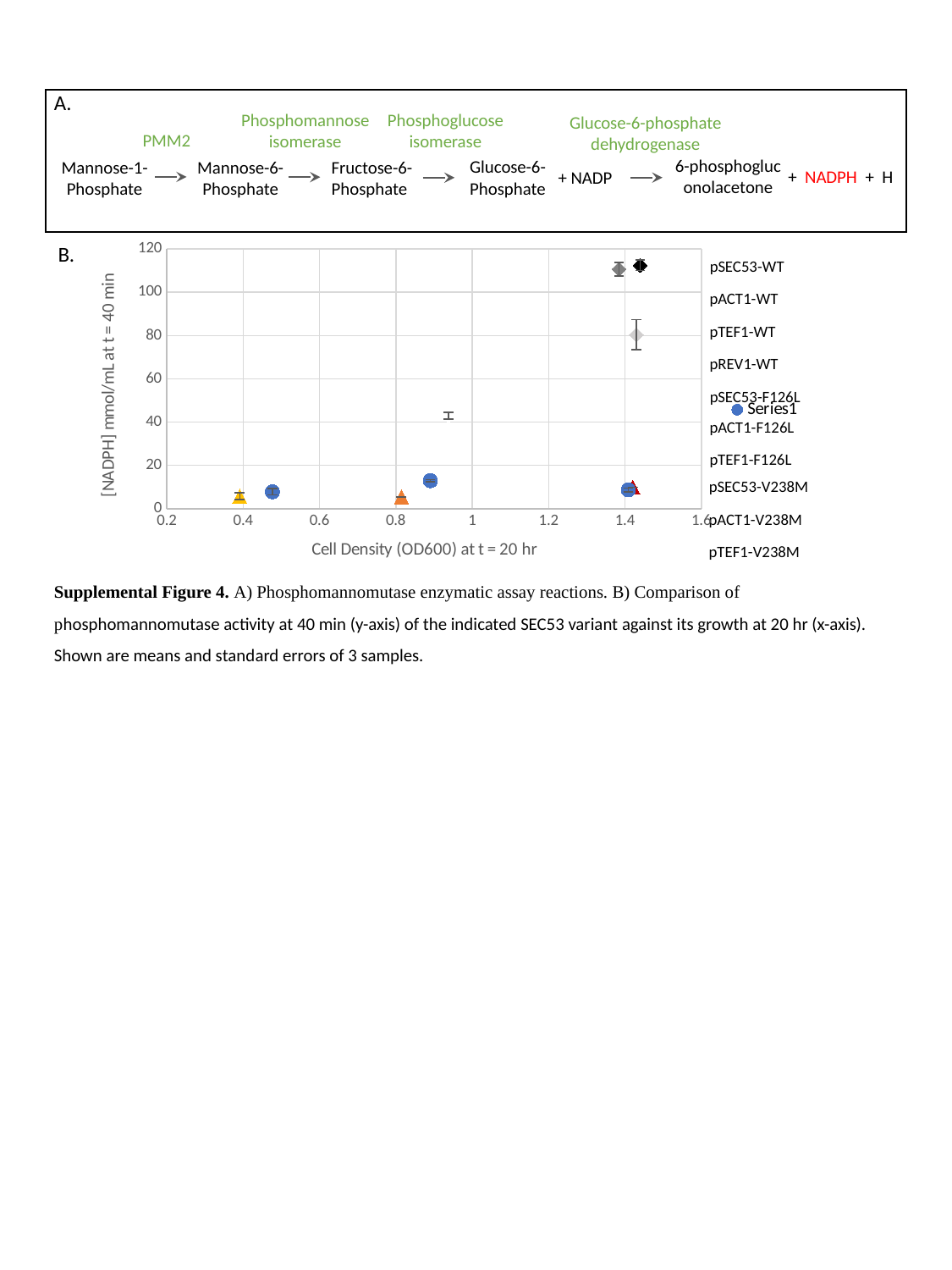
In panel B, are the lowest points plotted near x = 1.4 greater or less than 20 on the y axis? less In panel B, what is the title of the y axis? [NADPH] mmol/mL at t = 40 min In panel B, which has the higher y value: the point near x = 0.93 or the point near x = 0.88? The point near x = 0.93 In panel B, are the highest points plotted near x = 1.4 greater or less than 100 on the y axis? greater What kind of chart is shown in panel B? Scatter chart In panel B, are the points plotted near x = 0.4 greater or less than 20 on the y axis? less In panel B, what is the title of the x axis? Cell Density (OD600) at t = 20 hr In panel B, which has the higher y value: the topmost points near x = 1.4 or the point near x = 1.43 at about the 80 line? The topmost points near x = 1.4 In panel B, which has the higher y value: the point near x = 0.93 or the topmost points near x = 1.4? The topmost points near x = 1.4